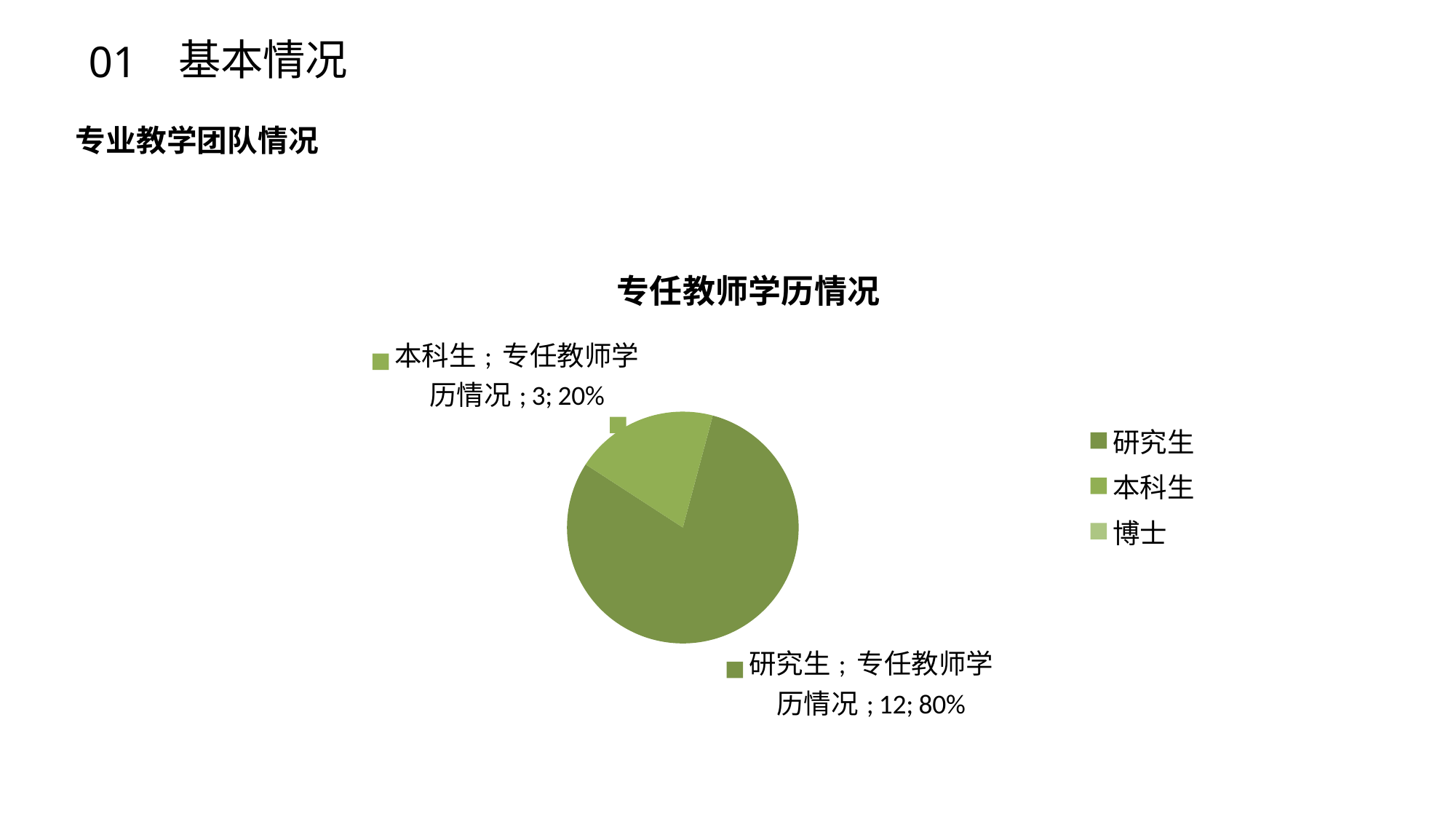
What share of the pie does 本科生 represent? 20% How many entries does the chart legend list? 3 Which legend entry is shown in the lightest green? 博士 What is the title of the chart? 专任教师学历情况 What is the total of the labelled values for 研究生 and 本科生? 15 What is the value for 本科生 in the chart? 3 What is the difference between the value for 研究生 and the value for 本科生? 9 What is the value for 研究生 in the chart? 12 Which is larger, the value for 研究生 or the value for 本科生? 研究生 Which category has the largest slice of the pie? 研究生 What kind of chart is shown on the slide? pie chart What share of the pie does 研究生 represent? 80%